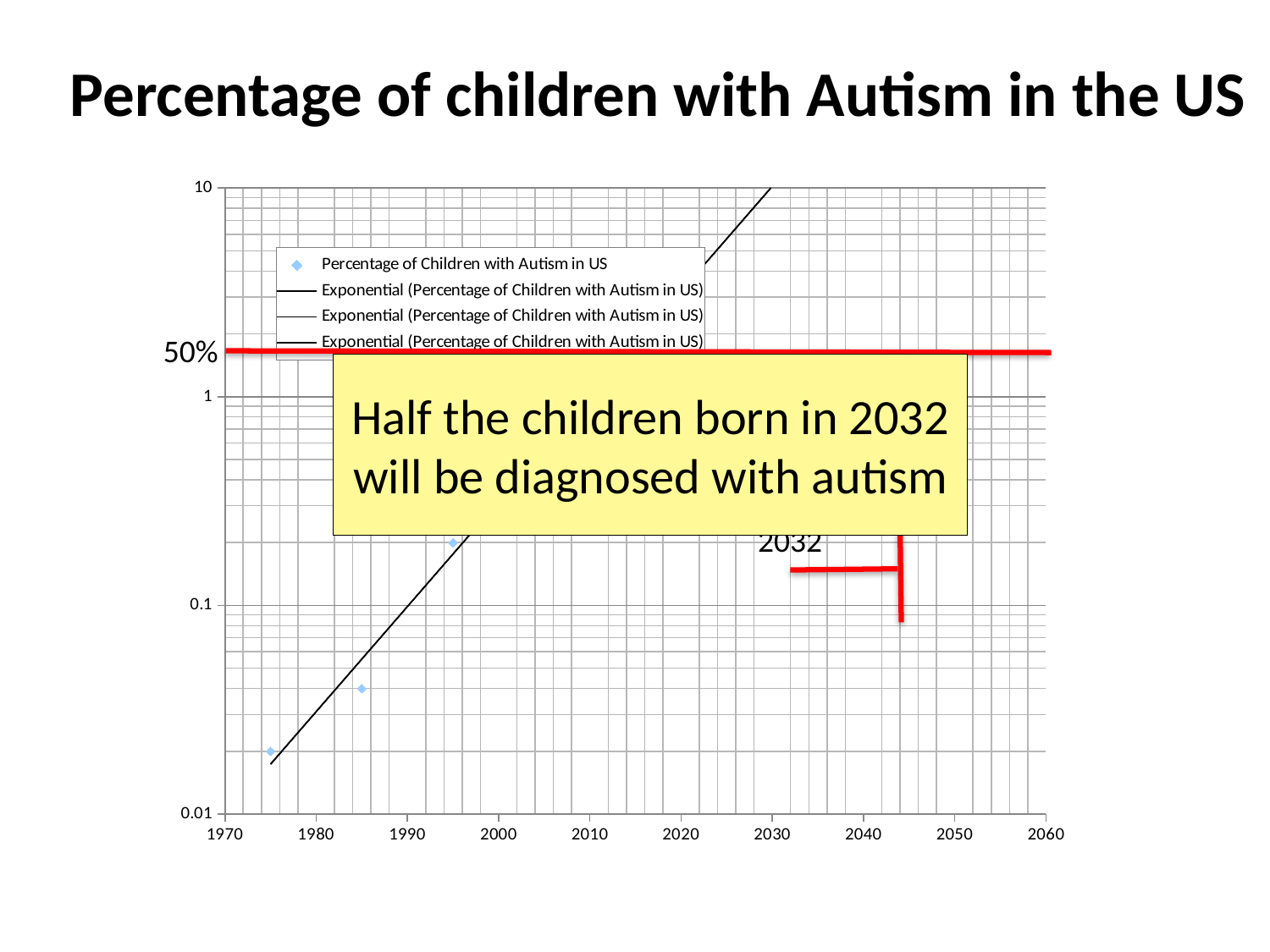
According to the annotation, in what year does the trendline reach 50%? 2032 What kind of chart is shown on the slide? scatter chart What is the title of the slide's chart? Percentage of children with Autism in the US How many entries does the chart's legend list? 4 Do the plotted values rise or fall as the year increases along the x axis? rise Is the value for the 1975 data point greater or less than 0.1? less Which of the visible data points has the lowest value? 1975 Which data point has the higher value, 1975 or 1995? 1995 Is the value for the 1985 data point greater or less than 0.1? less What is the highest value labelled on the y axis? 10 Is the value for the 1995 data point greater or less than 0.1? greater